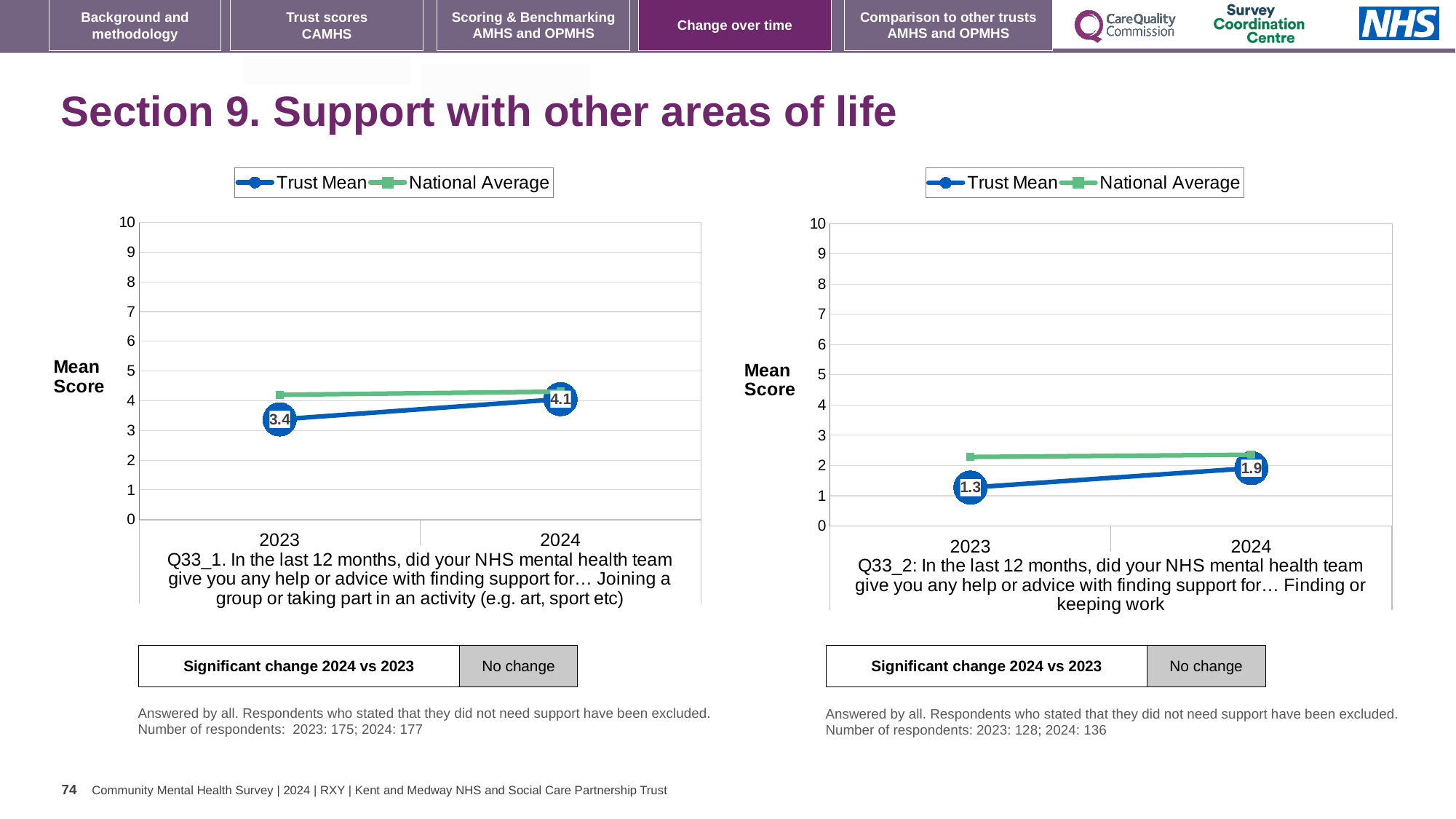
In the left chart (Q33_1), what is the Trust Mean for 2023? 3.4 How many series does the legend of the left chart (Q33_1) list? 2 In the left chart (Q33_1), which is larger in 2023, the Trust Mean or the National Average? National Average In the right chart (Q33_2), by how much did the Trust Mean change from 2023 to 2024? 0.6 In the left chart (Q33_1), does the Trust Mean rise or fall from 2023 to 2024? rise In the right chart (Q33_2), what is the Trust Mean for 2023? 1.3 In the right chart (Q33_2), what is the Trust Mean for 2024? 1.9 What type of chart is the right chart (Q33_2)? line chart In the left chart (Q33_1), what is the Trust Mean for 2024? 4.1 In the left chart (Q33_1), by how much did the Trust Mean change from 2023 to 2024? 0.7 In the right chart (Q33_2), is the National Average for 2023 greater or less than 2? greater How many years are plotted on the x axis of the right chart (Q33_2)? 2